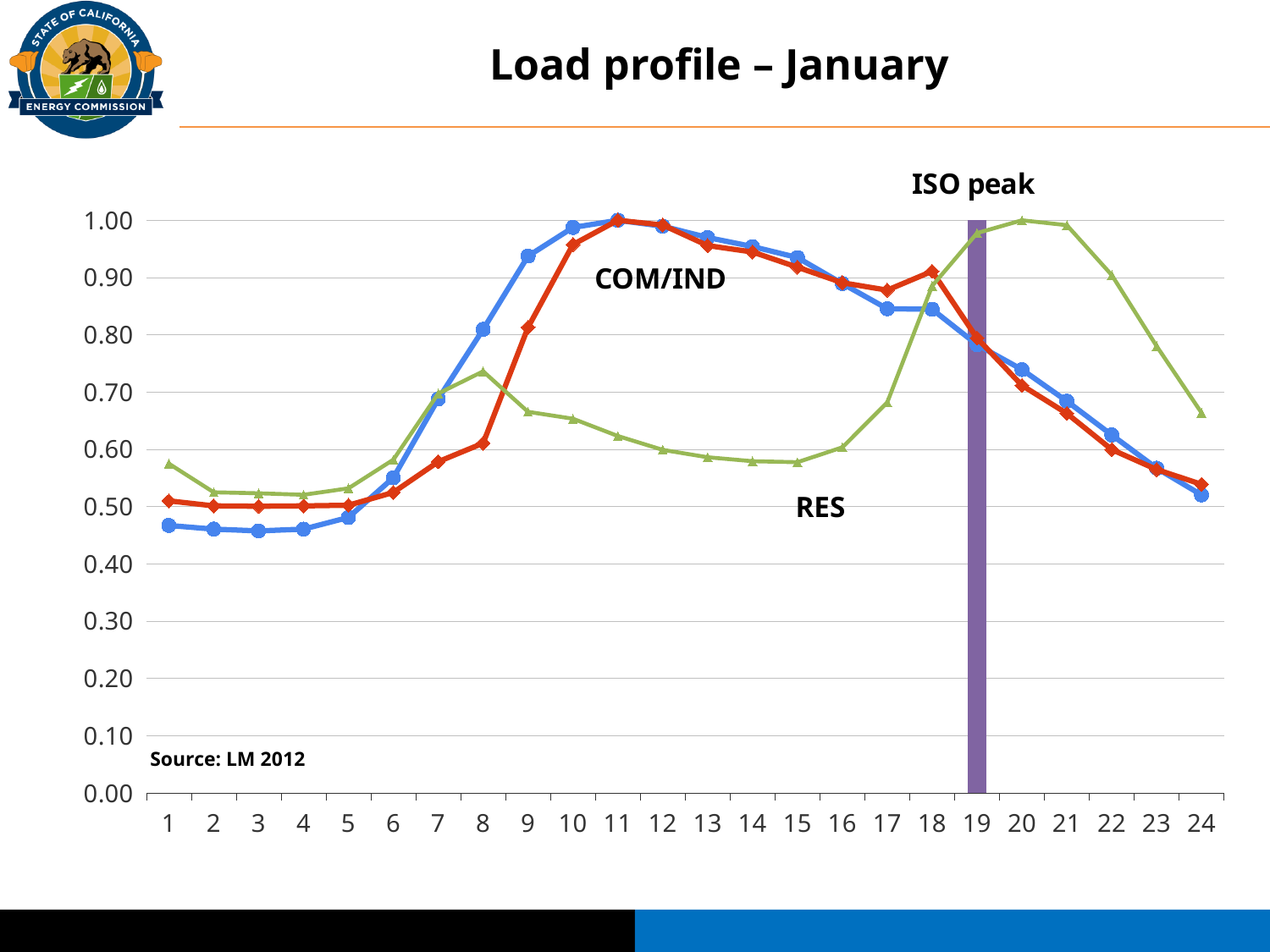
At which hour is the 'ISO peak' marker placed on the chart? 19 Is the value of the red line at hour 9 greater or less than 0.90? less Is the value of the blue line at hour 3 greater or less than 0.50? less At hour 20, which is larger: the RES line or the blue line? RES Is the value of the RES line at hour 1 greater or less than 0.50? greater Does the blue line rise or fall from hour 5 to hour 11? rise What kind of chart is shown on the slide? line chart At which hour does the RES line reach its highest value? 20 How many hours are shown along the x axis of the chart? 24 At hour 8, which is larger: the blue line or the red line? blue line Does the RES line rise or fall from hour 20 to hour 24? fall